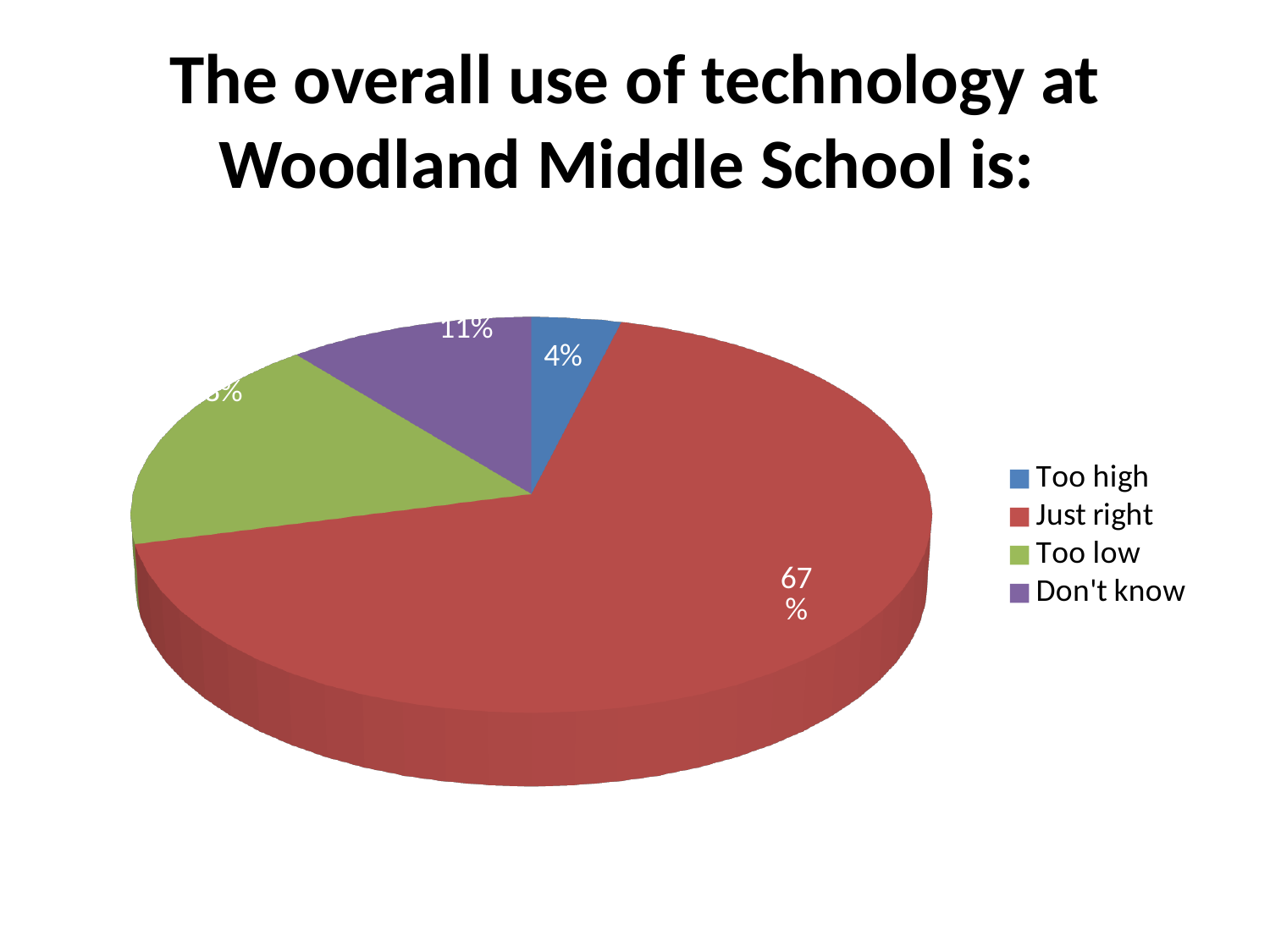
How many percentage points larger is the 'Just right' share than the 'Too high' share? 63 Which slice is larger, 'Don't know' or 'Too high'? Don't know Which response has the largest share of the pie? Just right What percentage of respondents said the overall use of technology is 'Too high'? 4% What percentage of respondents said the overall use of technology is 'Just right'? 67% Which response has the smallest share of the pie? Too high Which slice is larger, 'Too low' or 'Don't know'? Too low What colour is the 'Just right' slice? Red What kind of chart is shown on the slide? Pie chart How many percentage points larger is the 'Just right' share than the 'Don't know' share? 56 How many response categories are shown in the pie chart? 4 What percentage of respondents answered 'Don't know'? 11%